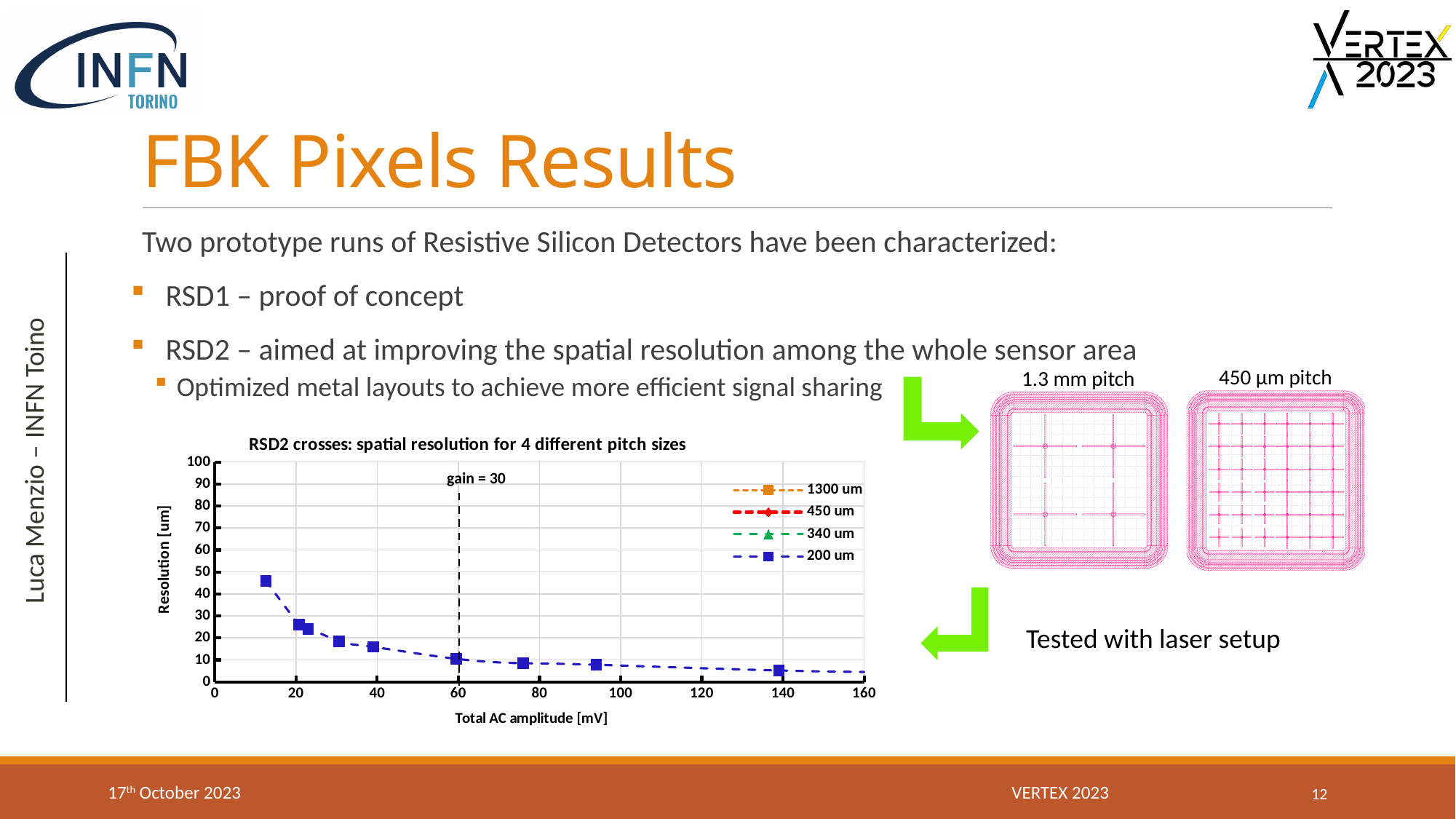
Is the resolution at the dashed 'gain = 30' line (60 mV) greater or less than 20? less What kind of chart is shown on the slide? line chart How many series does the legend of the chart list? 4 Is the resolution at a total AC amplitude of 140 mV greater or less than 10? less What is the label of the x axis of the chart? Total AC amplitude [mV] Is the resolution of the leftmost plotted point (lowest amplitude) greater or less than 40? greater What does the dashed vertical line in the chart mark? gain = 30 Which is larger: the resolution at about 40 mV or the resolution at about 140 mV? at about 40 mV Is the highest plotted resolution found at the lowest or the highest total AC amplitude? lowest Does the resolution rise or fall as the total AC amplitude increases along the x axis? fall